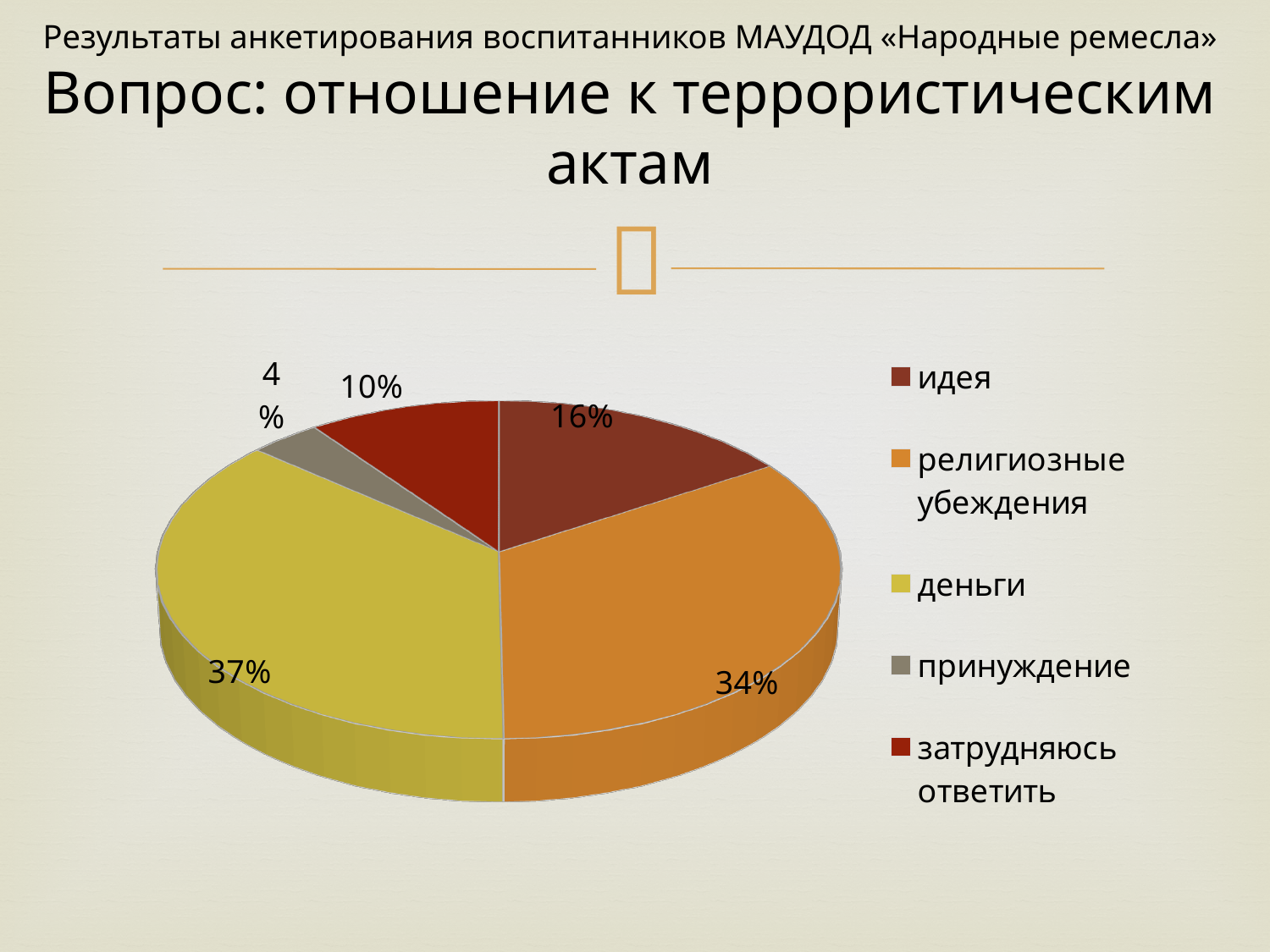
Which category has the smallest slice of the pie? принуждение How many categories does the pie chart have? 5 What share of the pie does «принуждение» have? 4% What share of the pie does «идея» have? 16% What share of the pie does «религиозные убеждения» have? 34% Which is larger, the share for «идея» or the share for «затрудняюсь ответить»? идея What kind of chart is shown on the slide? pie chart What is the difference between the shares for «деньги» and «религиозные убеждения»? 3% Which legend entry is shown in yellow? деньги Which category has the largest slice of the pie? деньги